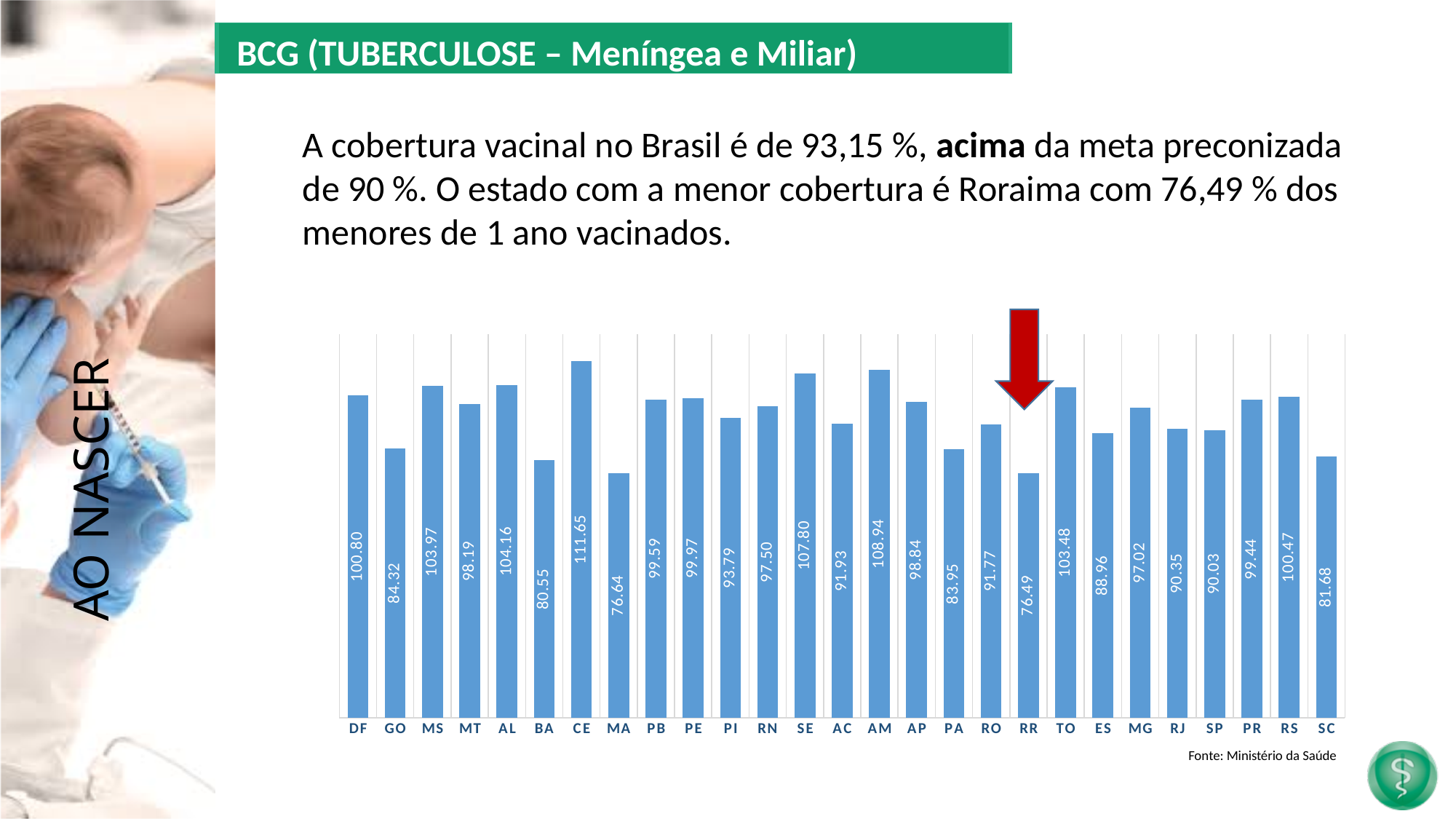
Which state has the highest value? CE Which state has the lowest value? RR What is the value for AM? 108.94 What is the value for SP? 90.03 What kind of chart is shown on the slide? Bar chart What is the difference between the values for CE and RR? 35.16 Which is larger, the value for BA or the value for MA? BA Which is larger, the value for SE or the value for TO? SE What is the value for CE? 111.65 How many states are shown on the chart? 27 What is the value for RR? 76.49 What is the difference between the values for DF and GO? 16.48